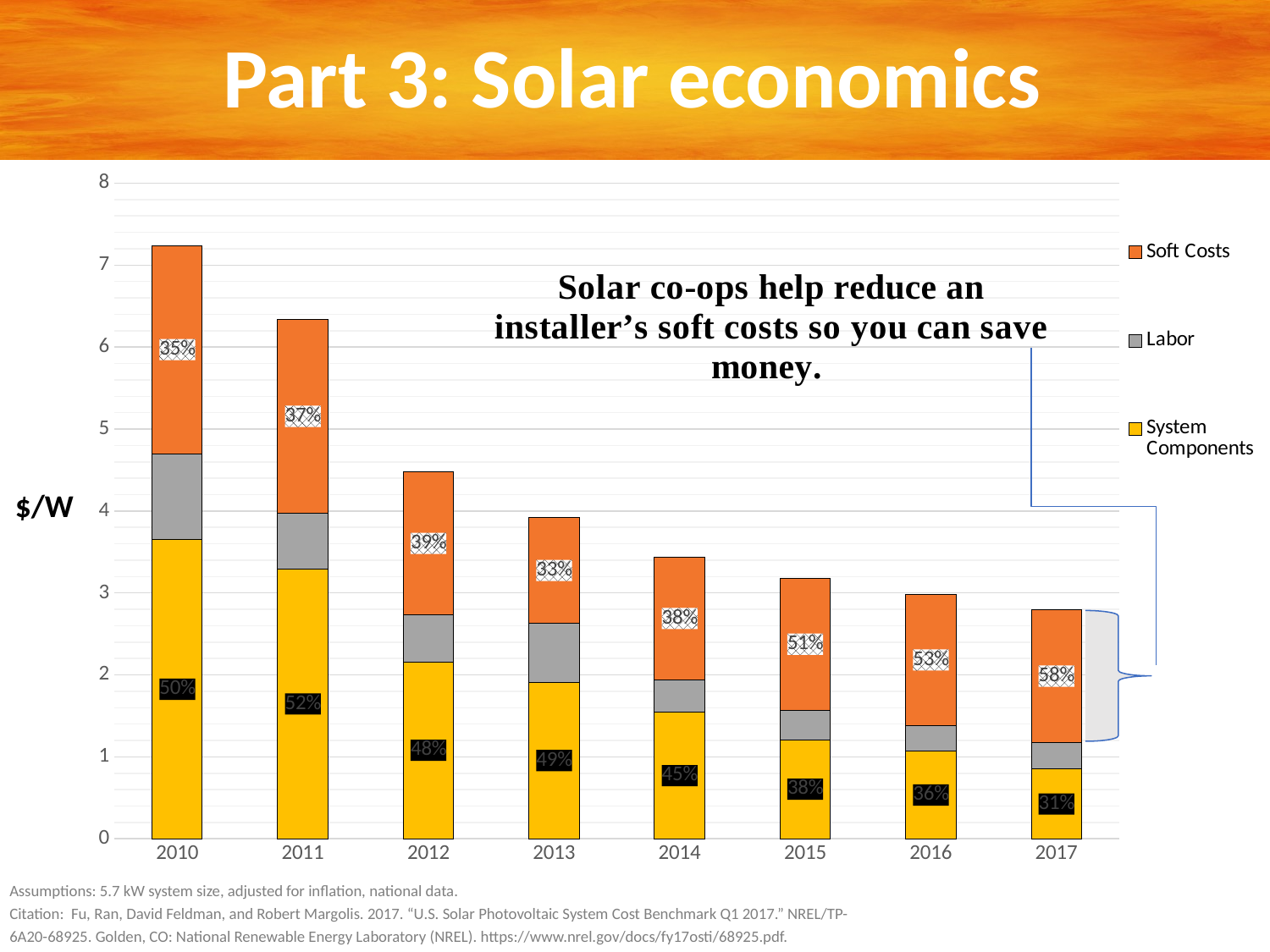
Is the total height of the 2010 bar greater or less than 7 $/W? greater What percentage label is shown on the System Components segment for 2010? 50% By how many percentage points does the Soft Costs share in 2017 exceed the Soft Costs share in 2010? 23 percentage points What percentage label is shown on the Soft Costs segment for 2013? 33% How many years are shown along the x axis? 8 What kind of chart is shown on the slide? Stacked bar chart Do the total bar heights rise or fall from 2010 to 2017? fall What percentage label is shown on the Soft Costs segment for 2017? 58% In which year is the System Components percentage label the lowest? 2017 In which year is the Soft Costs percentage label the highest? 2017 How many series does the legend list? 3 Is the total height of the 2017 bar greater or less than 3 $/W? less